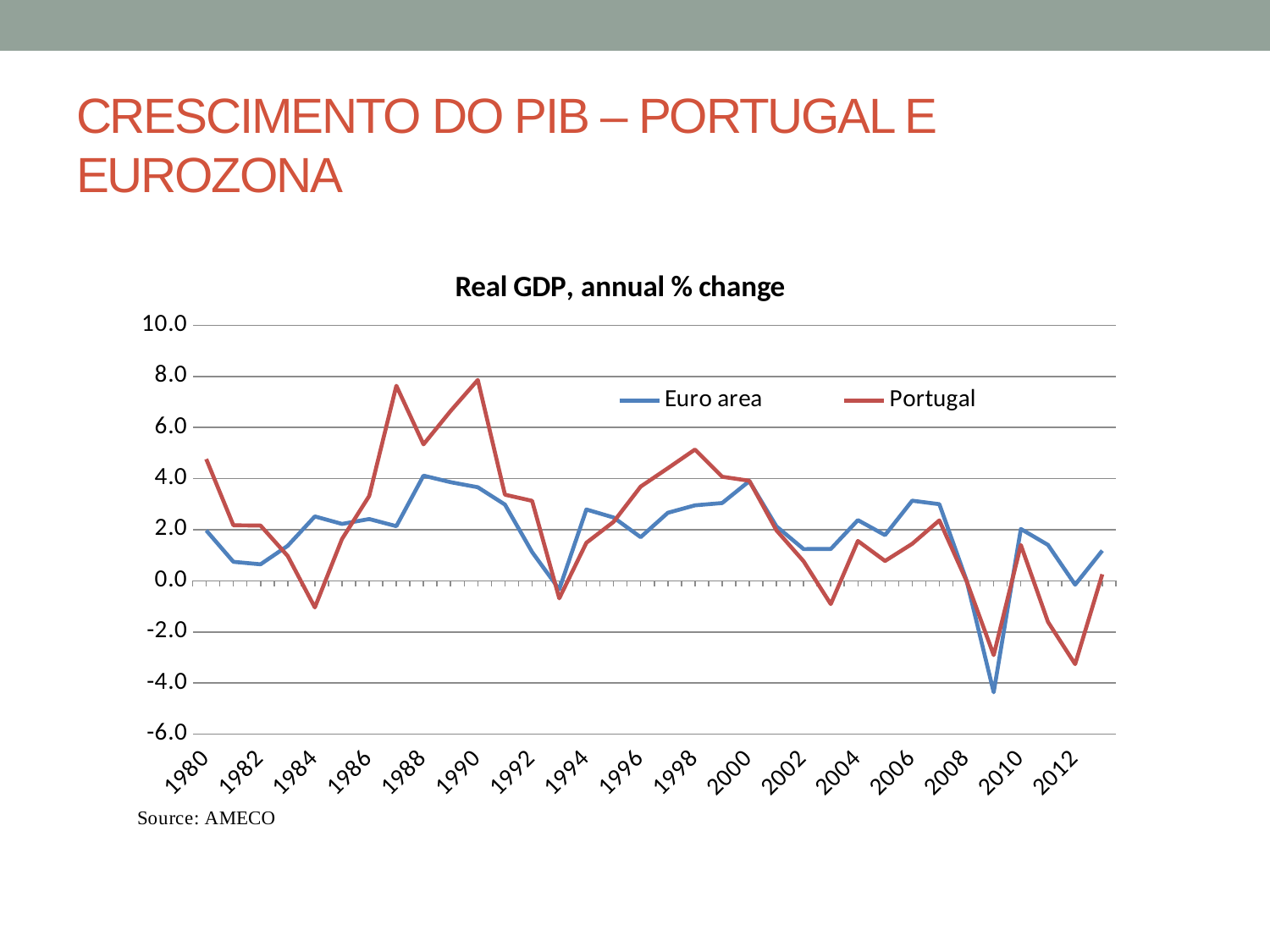
In 1990, which series has the higher value, Euro area or Portugal? Portugal How many series does the chart's legend list? 2 Is the value for Euro area in 1988 greater or less than 2.0? greater In 2012, which series has the higher value, Euro area or Portugal? Euro area Is the value for Portugal in 1990 greater or less than 6.0? greater In 1984, which series has the higher value, Euro area or Portugal? Euro area What is the title of the chart? Real GDP, annual % change In which year does the Euro area series reach its lowest value? 2009 What kind of chart is shown on the slide? Line chart Is the value for Portugal in 1984 greater or less than 0.0? less What are the two series named in the chart's legend? Euro area and Portugal